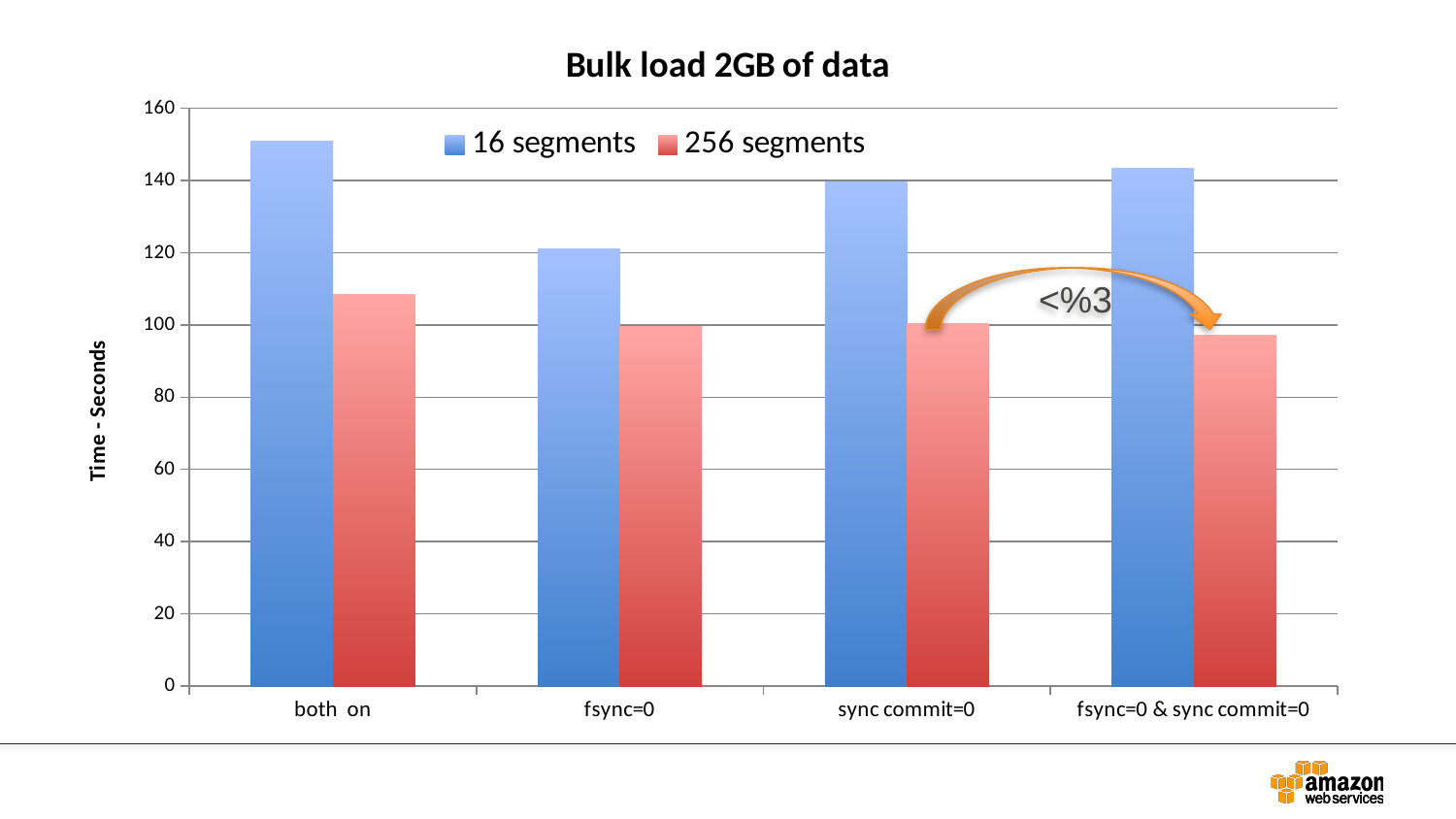
How many categories are shown along the x axis? 4 Which category has the highest value for 16 segments? both on Is the 256 segments value for 'both on' greater or less than 100? greater What is the label of the vertical axis? Time - Seconds Which category has the highest value for 256 segments? both on Which category has the lowest value for 16 segments? fsync=0 Is the 16 segments value for 'both on' greater or less than 140? greater How many series does the legend list? 2 What kind of chart is shown on the slide? bar chart Is the 16 segments value for 'fsync=0' greater or less than 140? less For 'sync commit=0', which series has the larger value, 16 segments or 256 segments? 16 segments What is the title of the chart? Bulk load 2GB of data